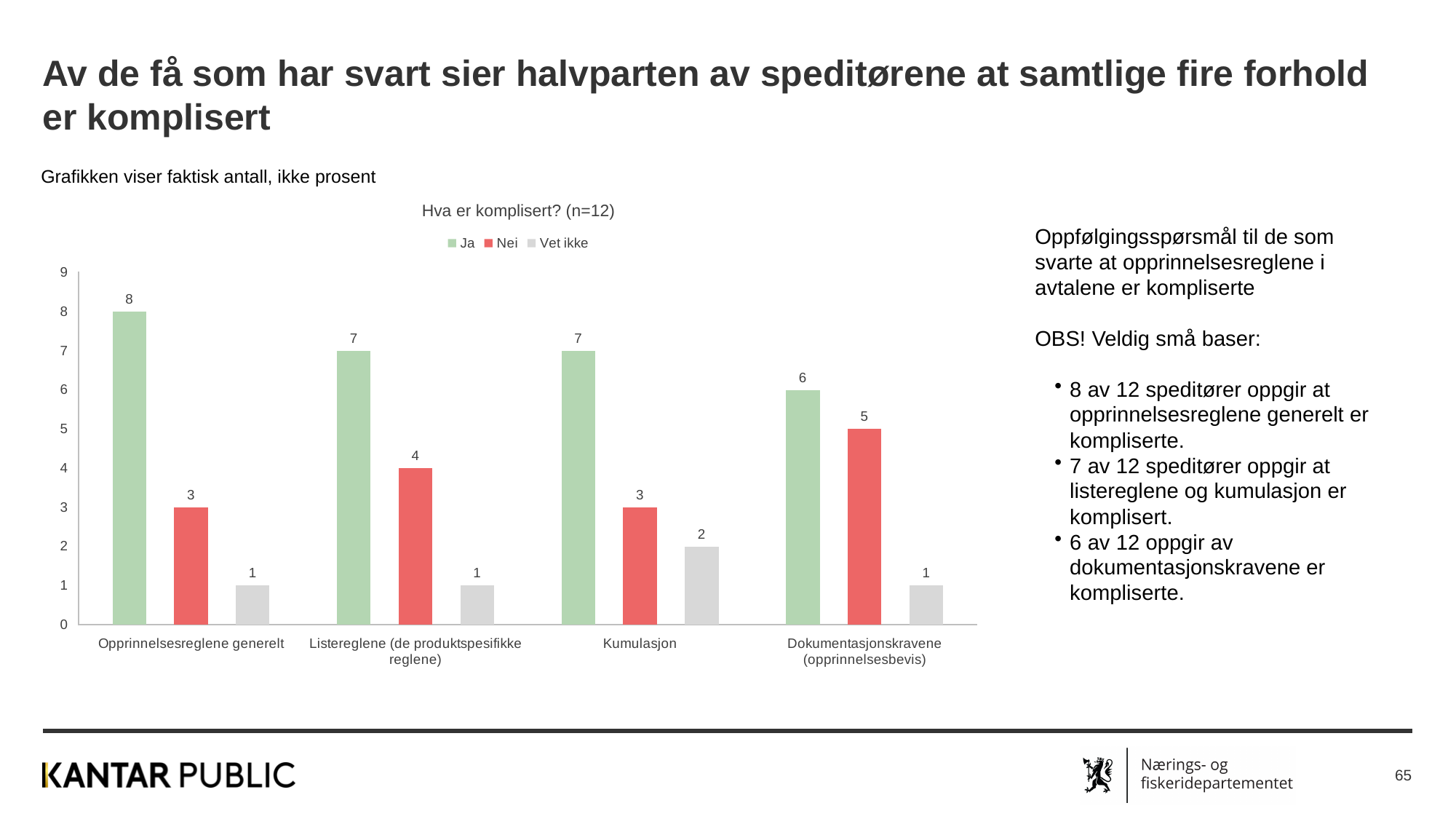
Which category has the lowest "Nei" value? Opprinnelsesreglene generelt and Kumulasjon (both 3) Which is larger for Dokumentasjonskravene (opprinnelsesbevis): the "Ja" value or the "Nei" value? Ja Which category has the highest "Ja" value? Opprinnelsesreglene generelt How many categories are shown on the x axis? 4 What is the value for "Nei" for Dokumentasjonskravene (opprinnelsesbevis)? 5 Which colour represents the "Nei" series? Red What is the value for "Ja" for Opprinnelsesreglene generelt? 8 What is the value for "Vet ikke" for Kumulasjon? 2 What is the difference between the "Ja" and "Nei" values for Listereglene (de produktspesifikke reglene)? 3 What is the title of the chart? Hva er komplisert? (n=12) What kind of chart is shown? Bar chart How many series does the legend list? 3